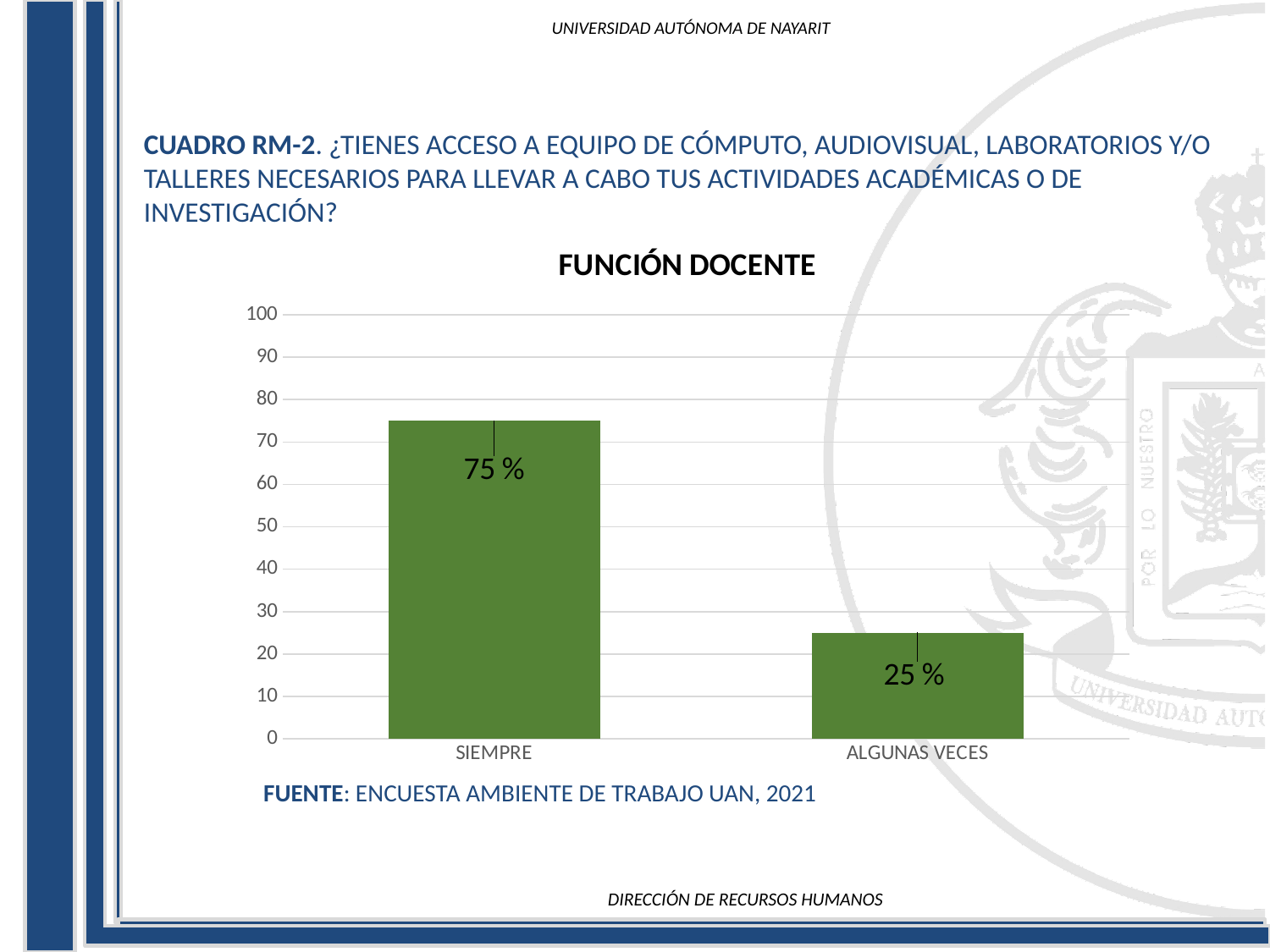
Is the value for ALGUNAS VECES greater or less than 30? less What is the maximum value shown on the vertical axis? 100 How many categories are shown on the x axis? 2 Which is larger, the value for SIEMPRE or the value for ALGUNAS VECES? SIEMPRE What is the value for SIEMPRE? 75 % What kind of chart is shown on the slide? bar chart What is the title of the chart? FUNCIÓN DOCENTE Is the value for SIEMPRE greater or less than 70? greater What is the difference between the values for SIEMPRE and ALGUNAS VECES? 50 % Which category has the highest value? SIEMPRE Which category has the lowest value? ALGUNAS VECES What is the value for ALGUNAS VECES? 25 %